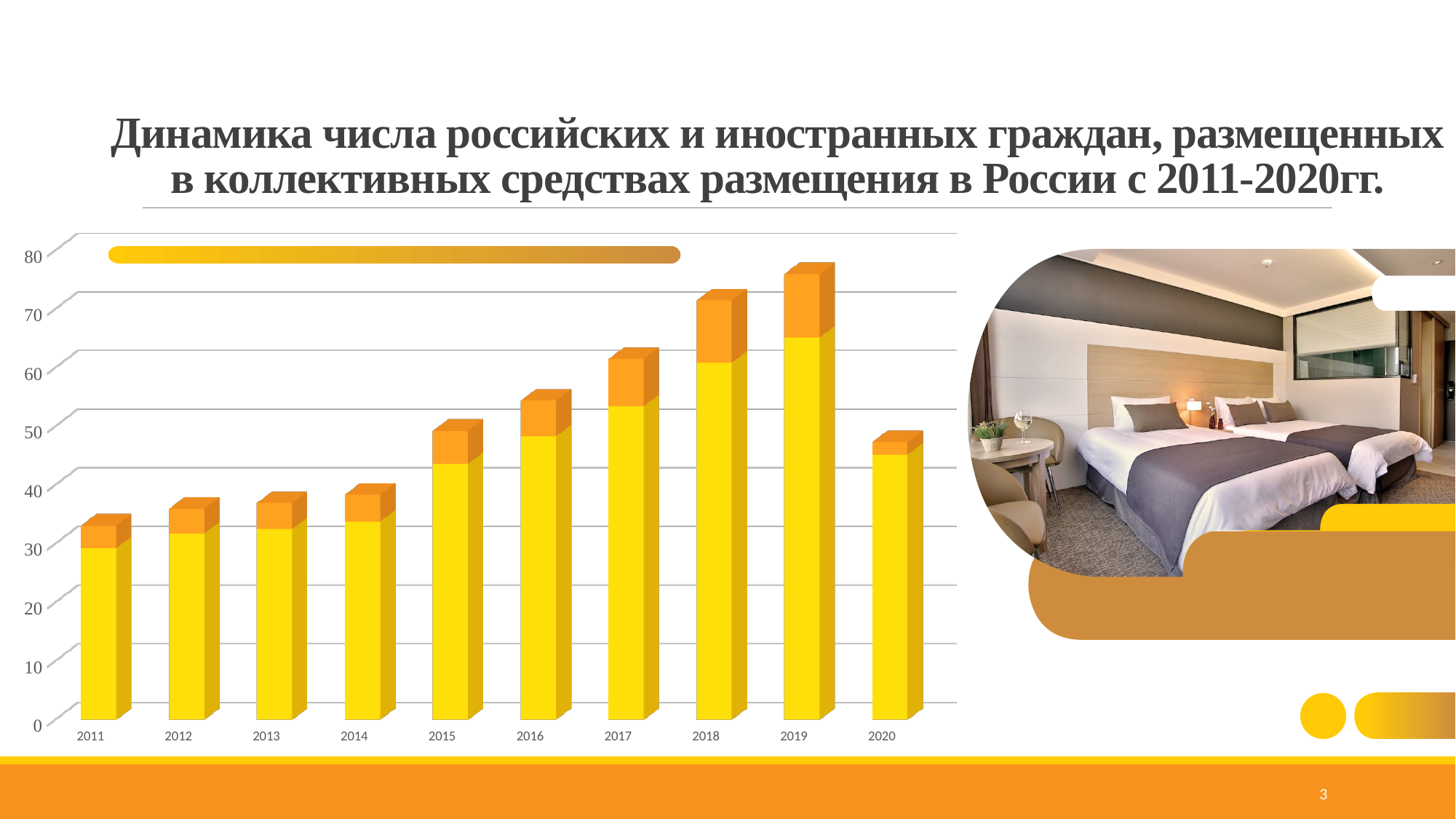
Which year has the larger total bar, 2017 or 2018? 2018 Which year has the lowest total bar? 2011 How many coloured segments make up each stacked bar? 2 Do the total bar values rise or fall from 2011 to 2019? rise How many years are shown on the x axis of the chart? 10 What kind of chart is shown on the slide? bar chart Is the total value for 2012 greater or less than 30? greater Is the total value for 2020 greater or less than 50? less Which year has the larger total bar, 2014 or 2020? 2020 Which year has the highest total bar? 2019 Is the total value for 2016 greater or less than 50? greater